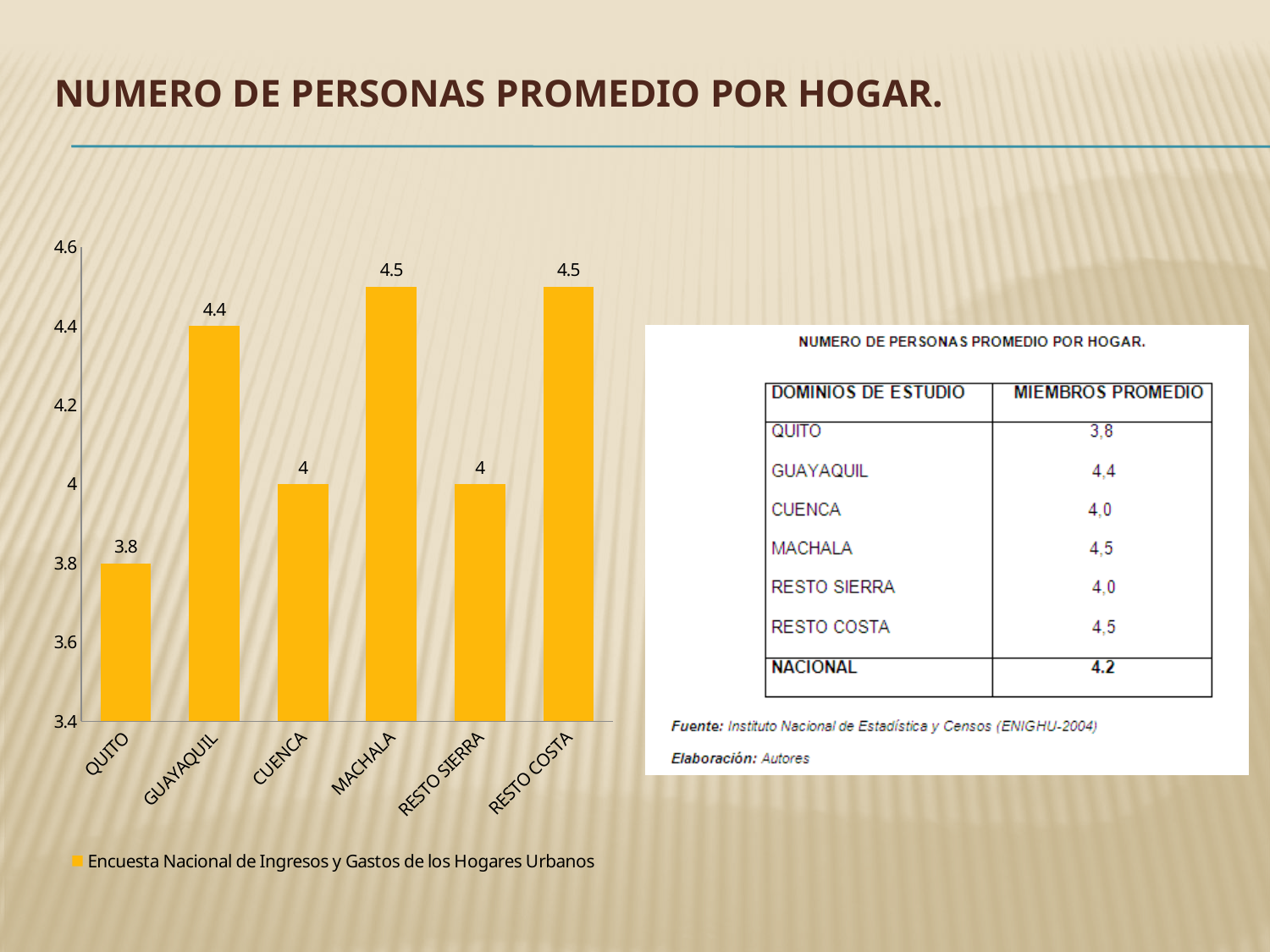
What is the value for GUAYAQUIL? 4.4 What is the difference between the values for MACHALA and CUENCA? 0.5 Is the value for QUITO greater or less than 4? less What is the difference between the values for GUAYAQUIL and QUITO? 0.6 How many categories are shown on the x axis? 6 Which category has the lowest value? QUITO What is the value for CUENCA? 4 What kind of chart is shown? bar chart What is the value for QUITO? 3.8 Which is larger, the value for GUAYAQUIL or the value for RESTO SIERRA? GUAYAQUIL What is the legend entry for the series? Encuesta Nacional de Ingresos y Gastos de los Hogares Urbanos How many series does the legend list? 1